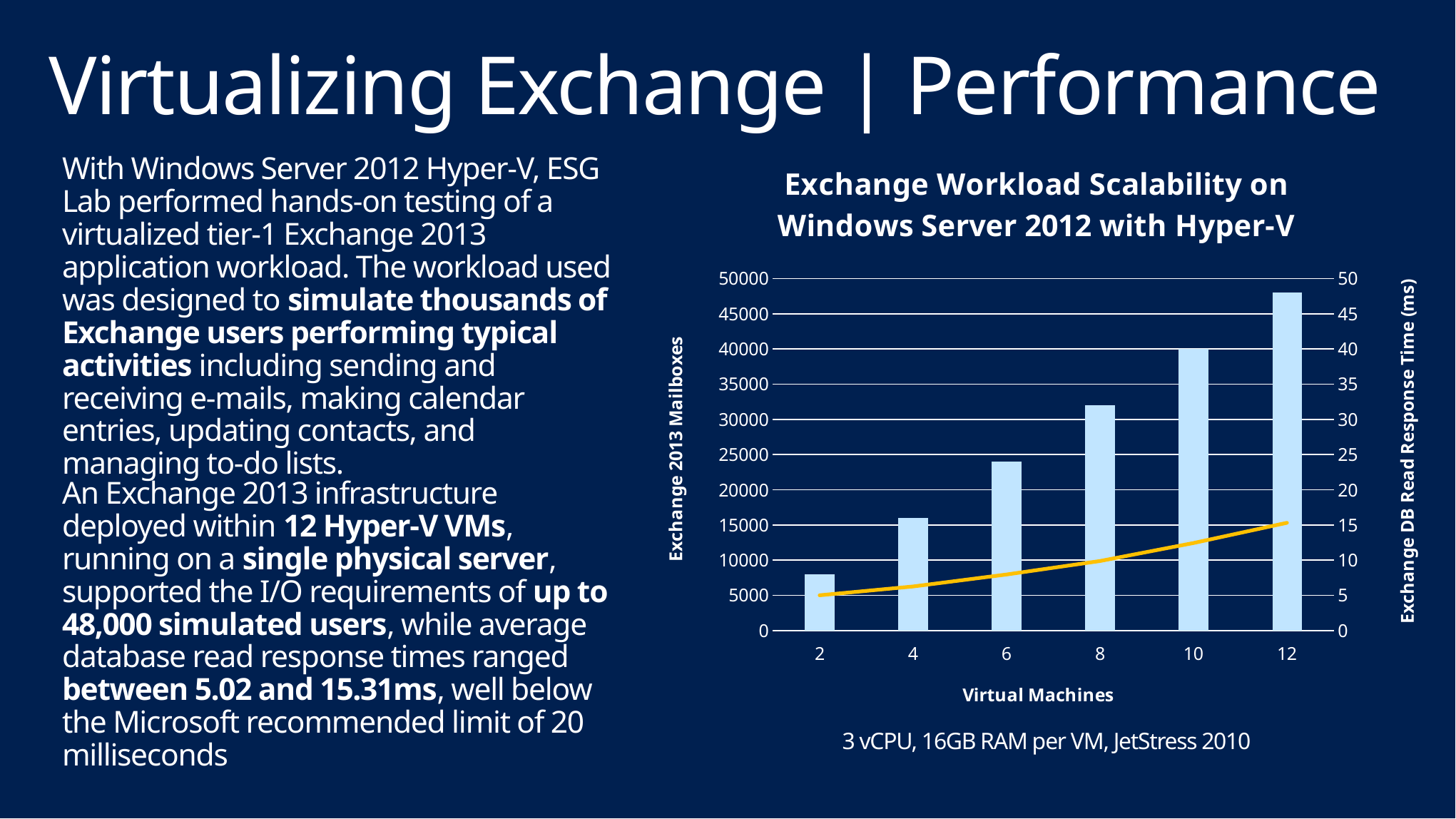
Is the Exchange 2013 Mailboxes value for 12 virtual machines greater or less than 45000? greater Which virtual machine count has the shortest Exchange 2013 Mailboxes bar? 2 How many virtual machine categories are plotted along the x axis? 6 Which virtual machine count has the tallest Exchange 2013 Mailboxes bar? 12 Are the Exchange 2013 Mailboxes values shown as bars or as a line? bars Is the Exchange 2013 Mailboxes value for 6 virtual machines greater or less than 25000? less What is the Exchange 2013 Mailboxes value for 10 virtual machines? 40000 Which has more Exchange 2013 Mailboxes, 8 virtual machines or 6 virtual machines? 8 virtual machines What is the title of the chart? Exchange Workload Scalability on Windows Server 2012 with Hyper-V Is the Exchange 2013 Mailboxes value for 2 virtual machines greater or less than 10000? less Do the Exchange 2013 Mailboxes bars rise or fall as the number of virtual machines increases? rise What is the label of the x axis of the chart? Virtual Machines